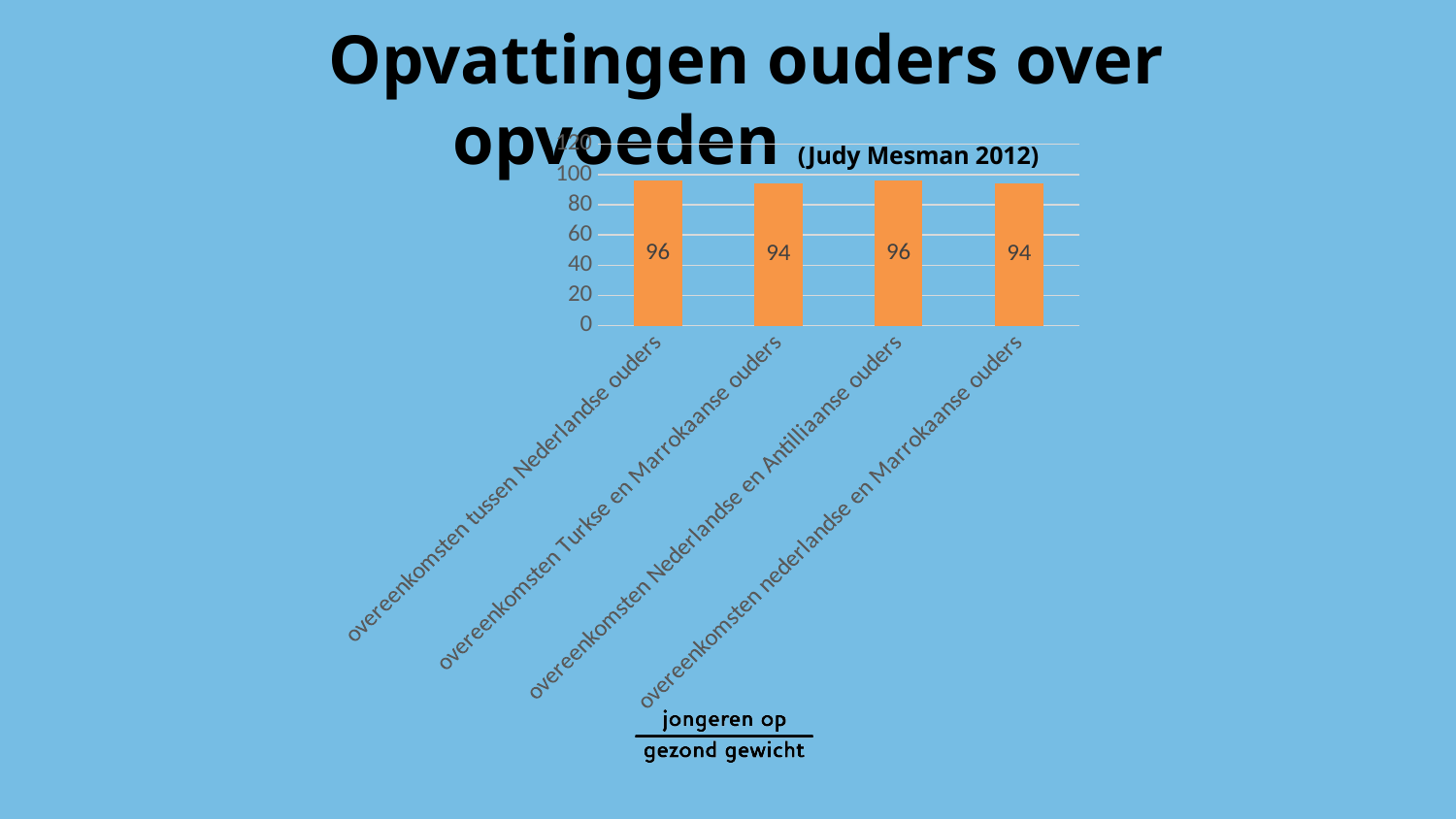
What kind of chart is shown on the slide? bar chart Is the value for 'overeenkomsten Turkse en Marrokaanse ouders' greater or less than 100? less What is the lowest value shown in the chart? 94 What is the highest value shown in the chart? 96 What is the value for 'overeenkomsten Nederlandse en Antilliaanse ouders'? 96 What is the difference between the value for 'overeenkomsten tussen Nederlandse ouders' and the value for 'overeenkomsten Turkse en Marrokaanse ouders'? 2 How many categories are shown in the chart? 4 What is the value for 'overeenkomsten Turkse en Marrokaanse ouders'? 94 What is the value for 'overeenkomsten nederlandse en Marrokaanse ouders'? 94 What is the value for 'overeenkomsten tussen Nederlandse ouders'? 96 Which is larger: the value for 'overeenkomsten Nederlandse en Antilliaanse ouders' or the value for 'overeenkomsten nederlandse en Marrokaanse ouders'? overeenkomsten Nederlandse en Antilliaanse ouders What is the title of the slide containing the chart? Opvattingen ouders over opvoeden (Judy Mesman 2012)